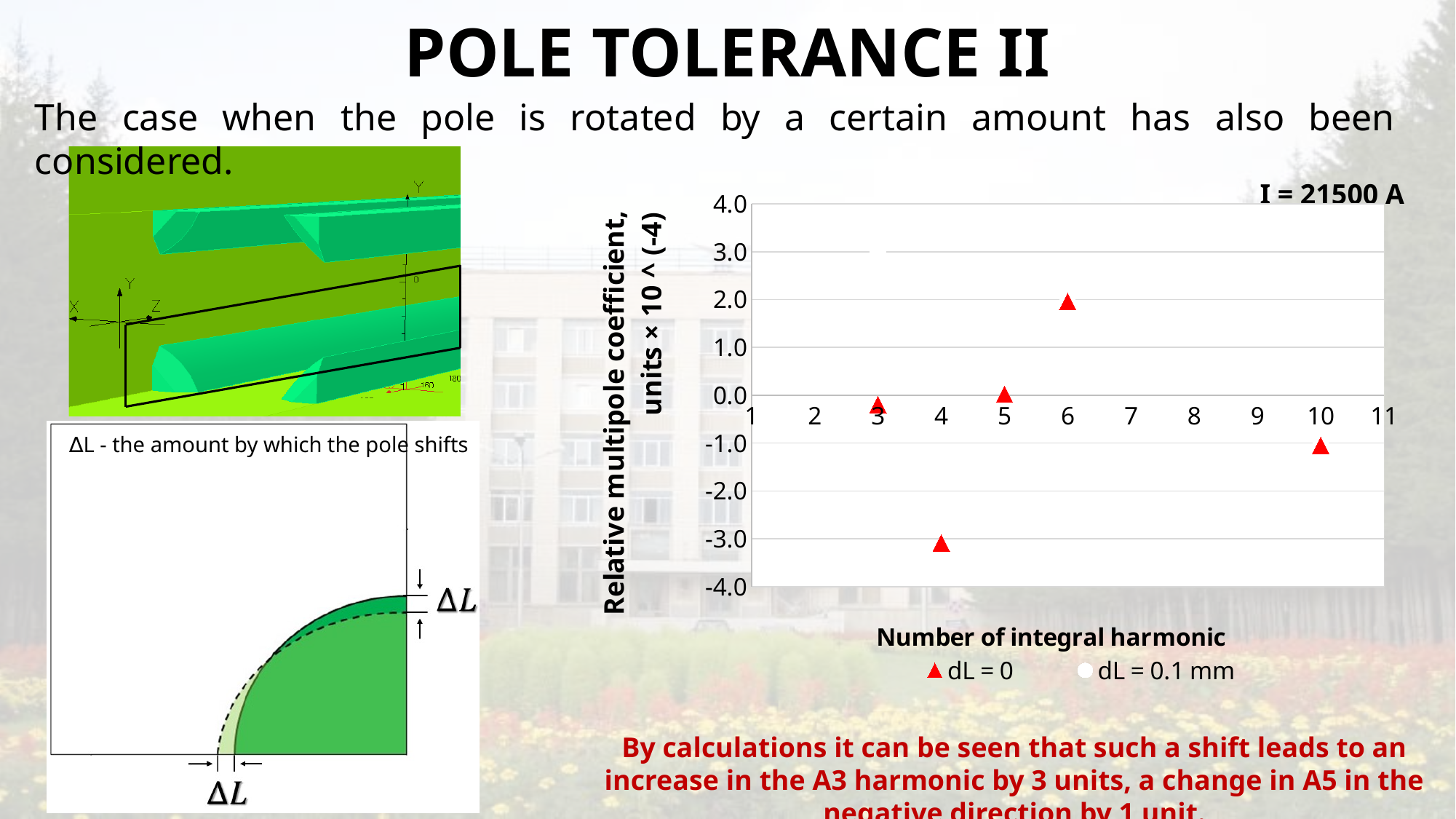
What kind of chart is shown on the slide? scatter chart How many series does the chart legend list? 2 For the dL = 0 series, which has the larger value: harmonic 6 or harmonic 10? harmonic 6 For the dL = 0 series, at which harmonic number is the plotted value highest? 6 Is the dL = 0 value at harmonic 6 greater or less than 1.0? greater For the dL = 0 series, at which harmonic number is the plotted value lowest? 4 What is the x-axis title of the chart? Number of integral harmonic Is the dL = 0 value at harmonic 6 greater or less than 3.0? less What are the two legend entries of the chart? dL = 0 and dL = 0.1 mm Is the dL = 0 value at harmonic 10 greater or less than 0.0? less For the dL = 0 series, which has the larger value: harmonic 4 or harmonic 10? harmonic 10